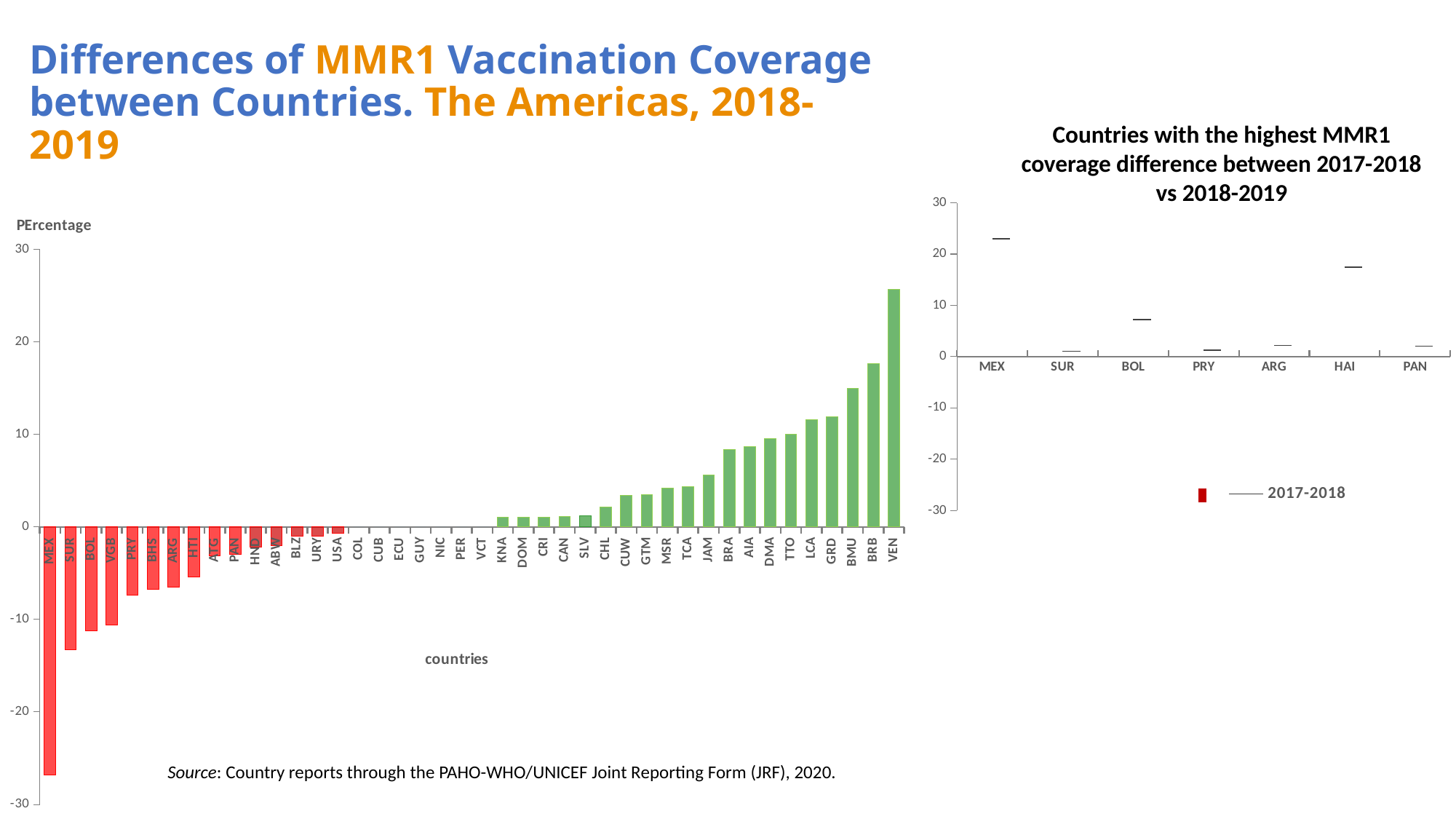
On the left chart, do the values rise or fall moving from left to right along the x axis? rise On the chart titled 'Countries with the highest MMR1 coverage difference between 2017-2018 vs 2018-2019', which country has the highest value? MEX On the chart titled 'Countries with the highest MMR1 coverage difference between 2017-2018 vs 2018-2019', is the value for HAI greater or less than 20? less On the left chart, which country has the lowest value? MEX On the left chart, is the value for BMU greater or less than 10? greater On the chart titled 'Countries with the highest MMR1 coverage difference between 2017-2018 vs 2018-2019', how many countries are shown on the x axis? 7 On the left chart, which is larger, the value for VEN or the value for BRB? VEN On the left chart, is the value for MEX greater or less than -20? less On the left chart, which country has the highest value? VEN On the chart titled 'Countries with the highest MMR1 coverage difference between 2017-2018 vs 2018-2019', what series does the legend list? 2017-2018 What kind of chart is the left chart? bar chart